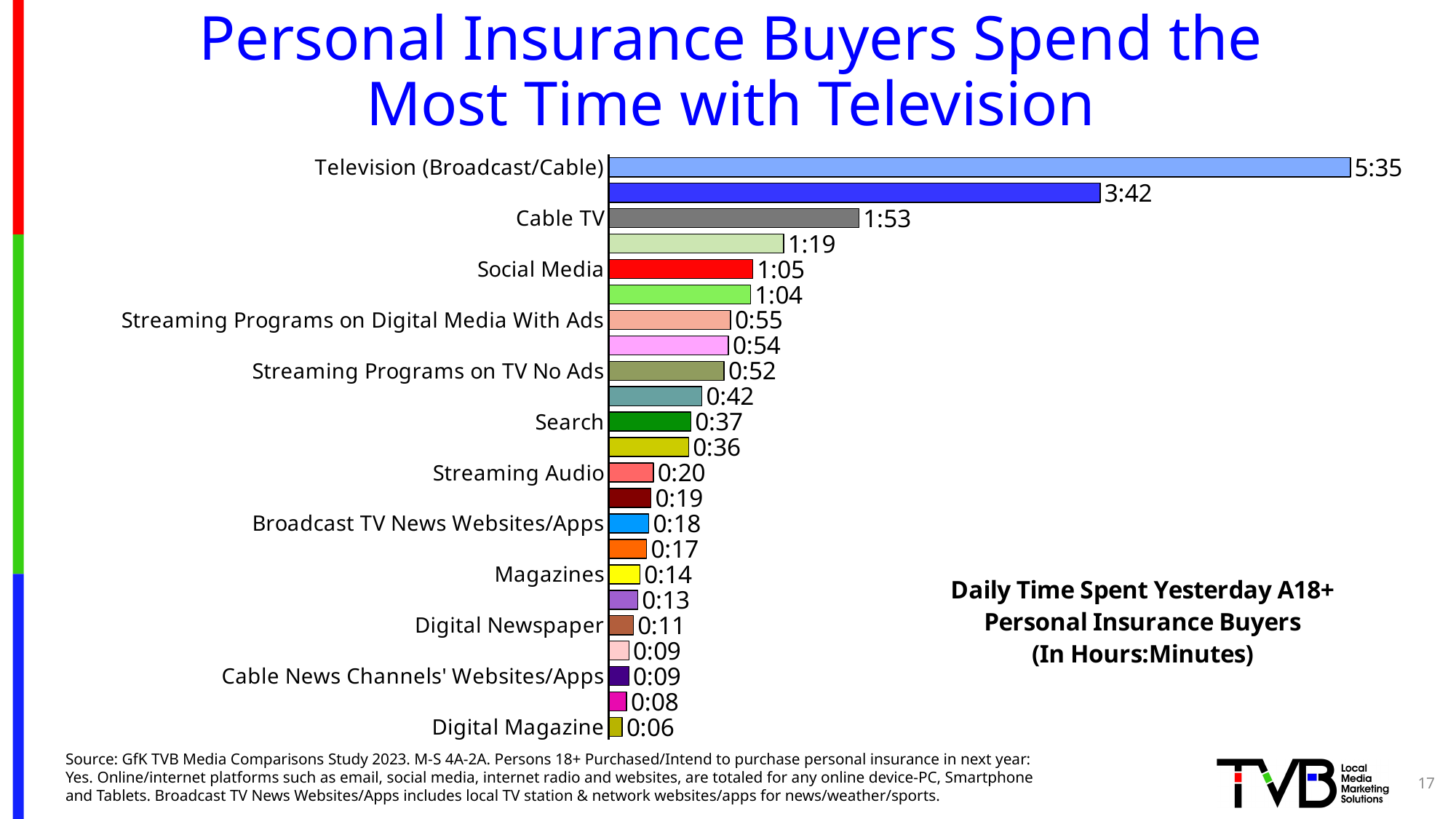
What is the daily time spent with Television (Broadcast/Cable) by personal insurance buyers? 5:35 What is the difference between Television (Broadcast/Cable) and Cable TV? 3:42 How much daily time is shown for Social Media? 1:05 What type of chart is shown on the slide? Bar chart What is the value for Streaming Programs on TV No Ads? 0:52 Which category has the highest daily time spent? Television (Broadcast/Cable) What is the value shown for Cable TV? 1:53 What is the value shown for Digital Newspaper? 0:11 Which is larger, Streaming Audio or Broadcast TV News Websites/Apps? Streaming Audio How many bars are plotted in the chart? 23 Which labeled category has the lowest daily time spent? Digital Magazine What is the difference between Social Media and Search? 0:28